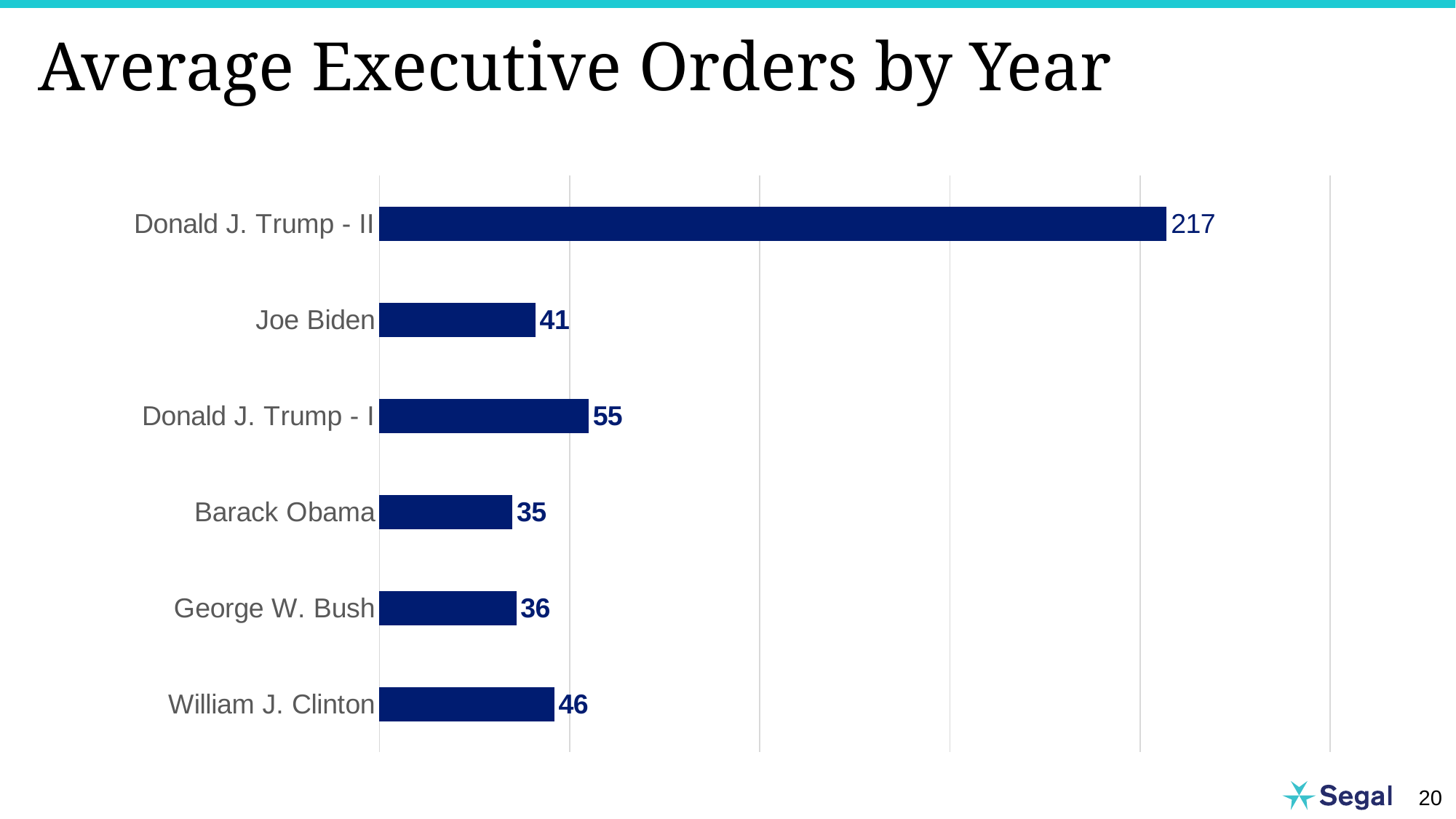
What is the difference between the values for Donald J. Trump - I and Joe Biden? 14 Which category has the highest value? Donald J. Trump - II Which category has the lowest value? Barack Obama What is the title of the slide? Average Executive Orders by Year Which is larger, the value for George W. Bush or the value for William J. Clinton? William J. Clinton How many categories are shown in the chart? 6 What is the difference between the values for Donald J. Trump - II and William J. Clinton? 171 What is the value for Barack Obama? 35 What is the value for Donald J. Trump - II? 217 What is the value for Joe Biden? 41 What is the value for William J. Clinton? 46 What kind of chart is shown on the slide? Bar chart